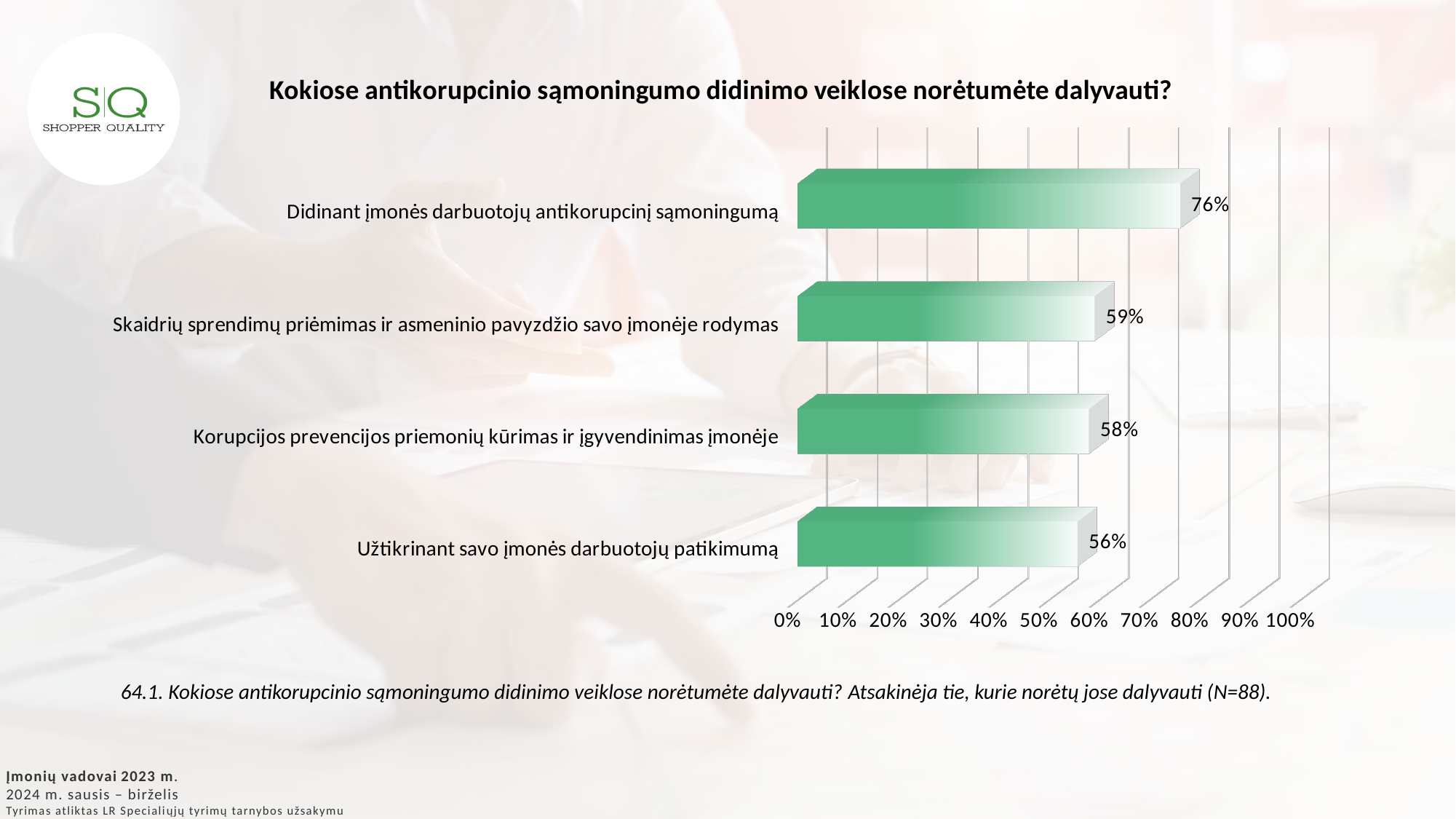
What is the difference between the values for "Didinant įmonės darbuotojų antikorupcinį sąmoningumą" and "Užtikrinant savo įmonės darbuotojų patikimumą"? 20% What is the difference between the values for "Skaidrių sprendimų priėmimas ir asmeninio pavyzdžio savo įmonėje rodymas" and "Korupcijos prevencijos priemonių kūrimas ir įgyvendinimas įmonėje"? 1% Which category has the lowest value? Užtikrinant savo įmonės darbuotojų patikimumą What is the value for "Korupcijos prevencijos priemonių kūrimas ir įgyvendinimas įmonėje"? 58% What is the value for "Skaidrių sprendimų priėmimas ir asmeninio pavyzdžio savo įmonėje rodymas"? 59% What is the value for "Didinant įmonės darbuotojų antikorupcinį sąmoningumą"? 76% Is the value for "Didinant įmonės darbuotojų antikorupcinį sąmoningumą" greater or less than 70%? greater What is the value for "Užtikrinant savo įmonės darbuotojų patikimumą"? 56% Which is larger: the value for "Didinant įmonės darbuotojų antikorupcinį sąmoningumą" or the value for "Skaidrių sprendimų priėmimas ir asmeninio pavyzdžio savo įmonėje rodymas"? Didinant įmonės darbuotojų antikorupcinį sąmoningumą What kind of chart is shown on the slide? Bar chart How many categories are shown in the chart? 4 Which category has the highest value? Didinant įmonės darbuotojų antikorupcinį sąmoningumą